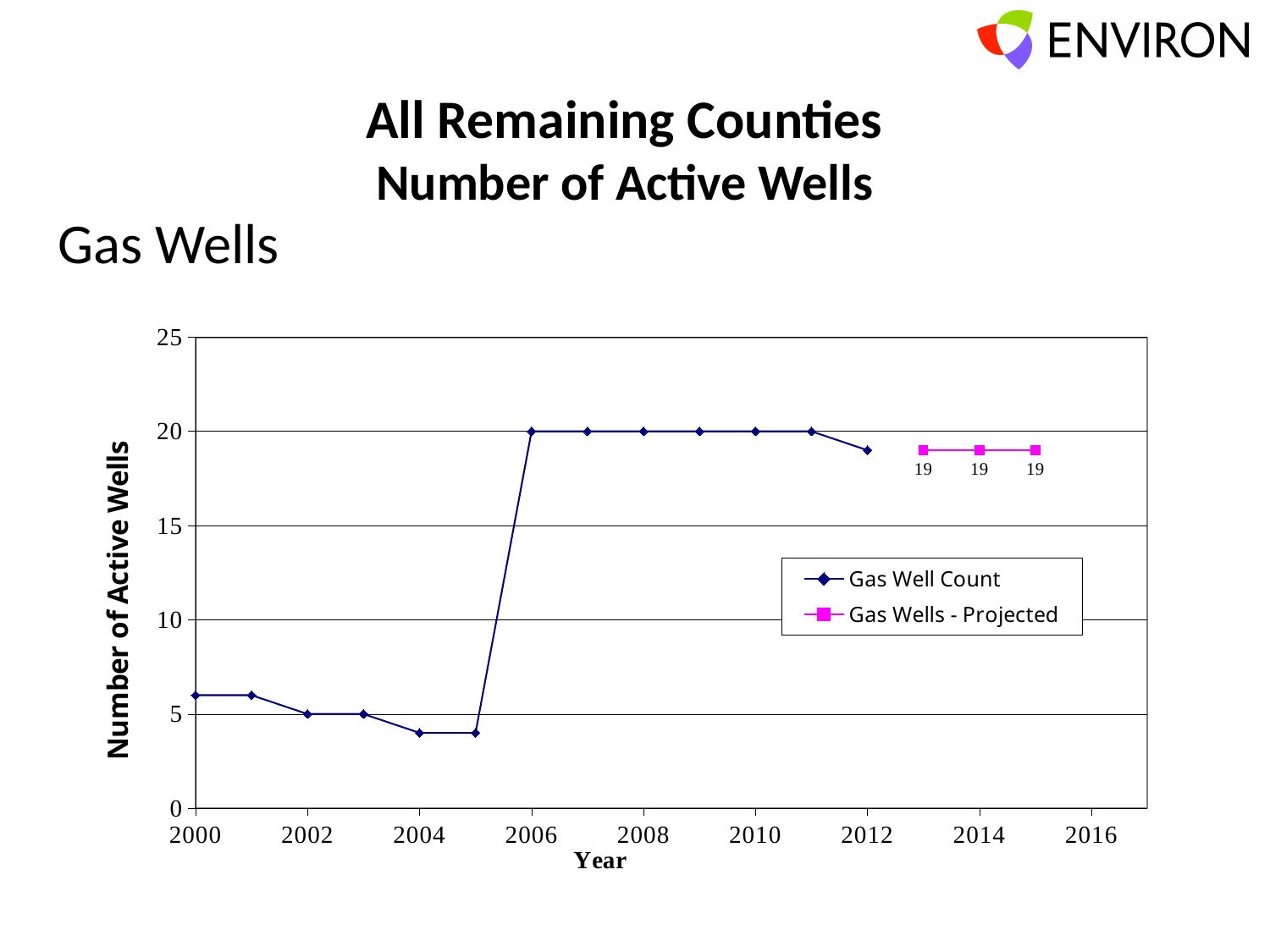
Is the Gas Well Count for 2004 greater or less than 5? less What is the projected number of gas wells for 2014? 19 How many series does the legend list? 2 How many data points does the Gas Wells - Projected series have? 3 Is the Gas Well Count for 2012 greater or less than 20? less Does the Gas Well Count rise or fall between 2000 and 2005? fall What is the Gas Well Count for 2002? 5 What is the Gas Well Count for 2008? 20 What kind of chart is shown on the slide? line chart What is the difference between the Gas Well Count in 2006 and in 2002? 15 How many data points does the Gas Well Count series have? 13 Which year has the larger Gas Well Count, 2005 or 2006? 2006